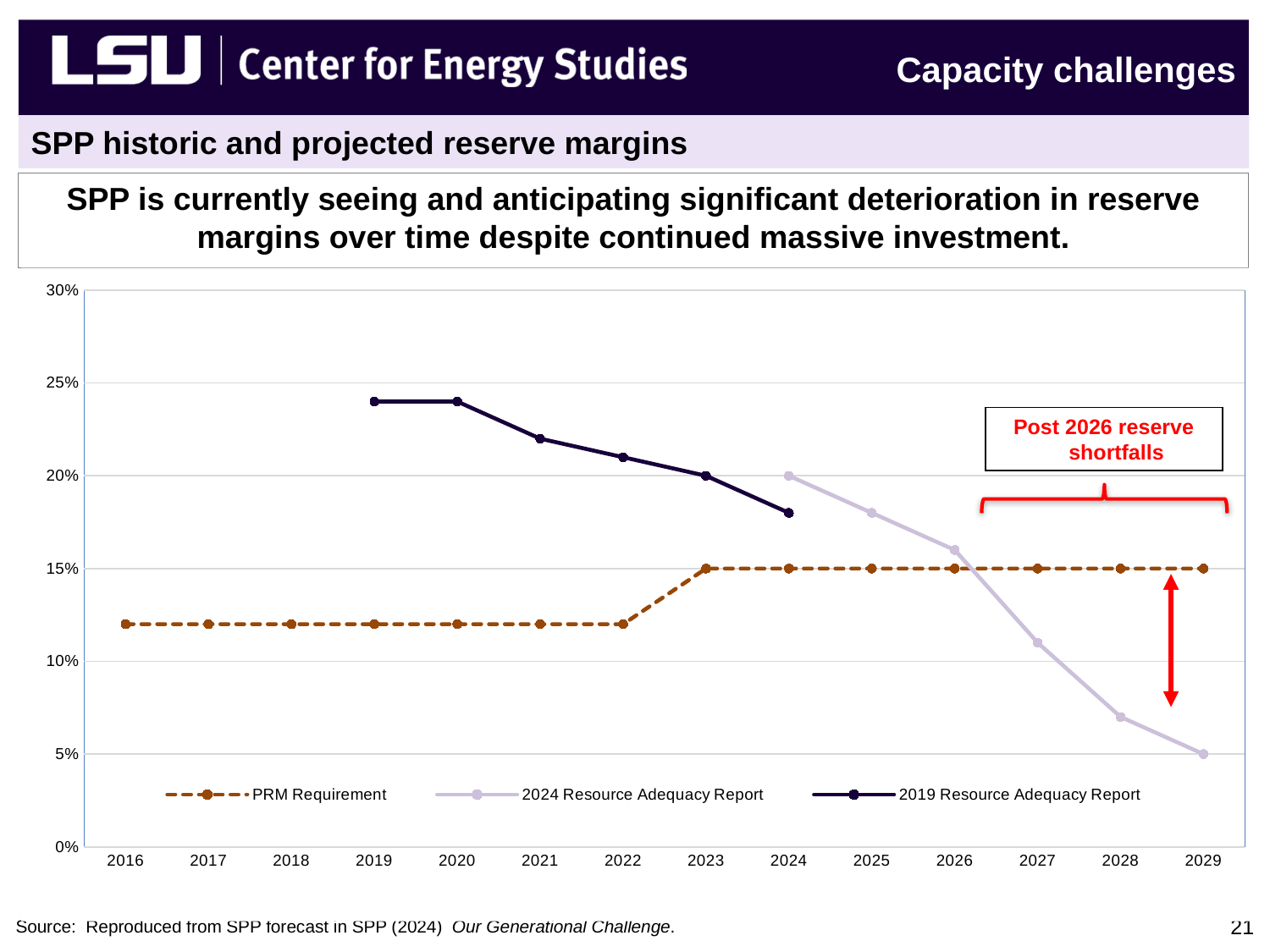
In 2028, which is larger: the PRM Requirement or the 2024 Resource Adequacy Report value? PRM Requirement How many series does the legend list? 3 What kind of chart is shown on the slide? line chart Is the PRM Requirement value for 2016 greater or less than 15%? less What is the 2024 Resource Adequacy Report value in 2024? 20% What is the 2019 Resource Adequacy Report value in 2023? 20% Is the 2019 Resource Adequacy Report value for 2019 greater or less than 20%? greater Does the 2024 Resource Adequacy Report series rise or fall from 2024 to 2029? fall What is the 2024 Resource Adequacy Report value in 2029? 5% What does the red annotation box on the chart say? Post 2026 reserve shortfalls How many years are shown on the x axis? 14 What is the PRM Requirement value in 2029? 15%